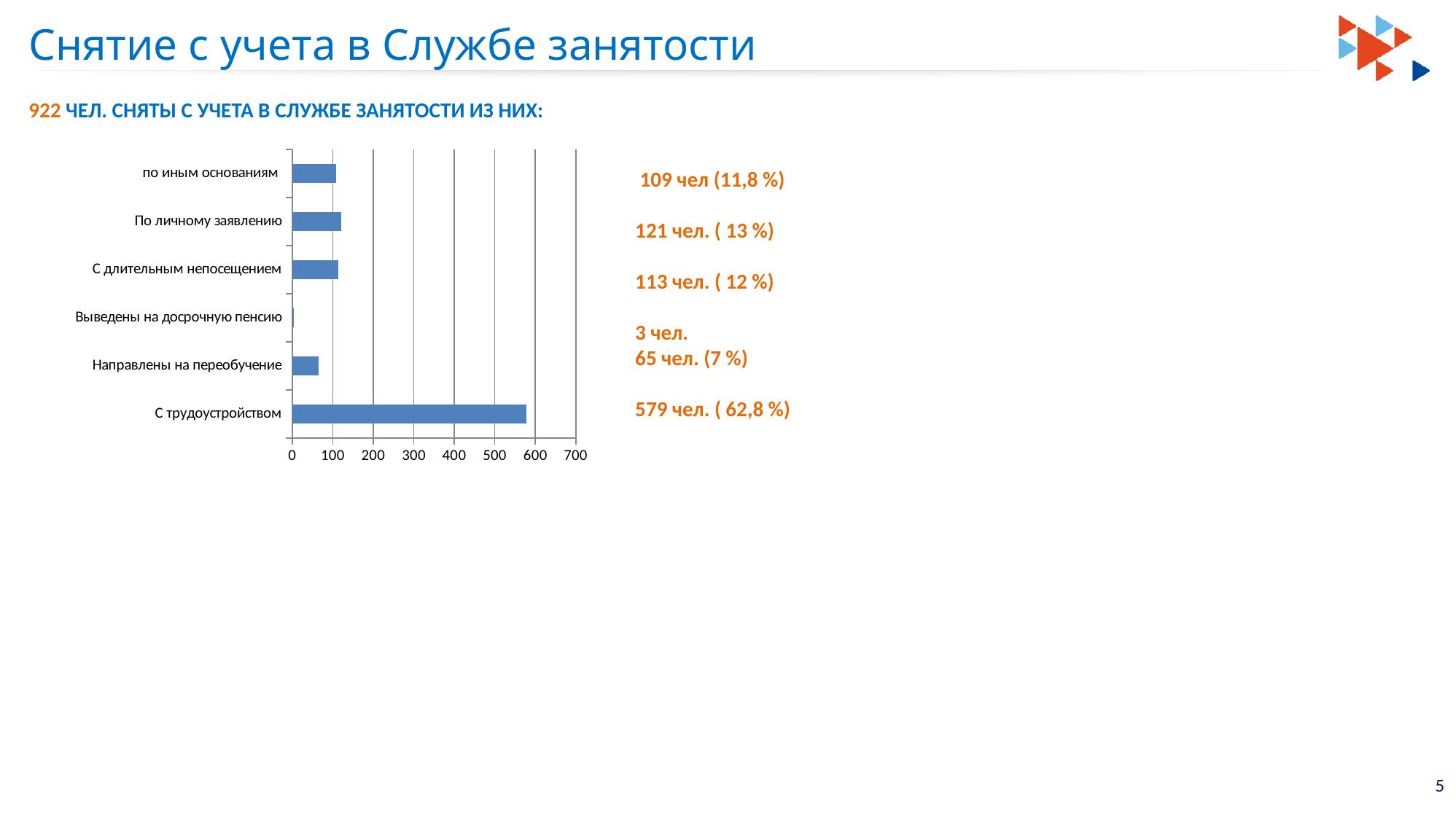
Which category has the lowest value in the chart? Выведены на досрочную пенсию Is the value for 'С трудоустройством' greater or less than 500? greater What is the difference between the values for 'С трудоустройством' and 'Направлены на переобучение'? 514 Is the value for 'Направлены на переобучение' greater or less than 100? less How many people were sent for retraining (Направлены на переобучение)? 65 What is the maximum value shown on the horizontal axis of the chart? 700 How many categories are shown in the chart? 6 Which is larger: the value for 'По личному заявлению' or for 'Направлены на переобучение'? По личному заявлению What is the value for 'По личному заявлению'? 121 What kind of chart is shown on the slide? bar chart Which category has the highest value in the chart? С трудоустройством How many people were removed from the register with employment (С трудоустройством)? 579